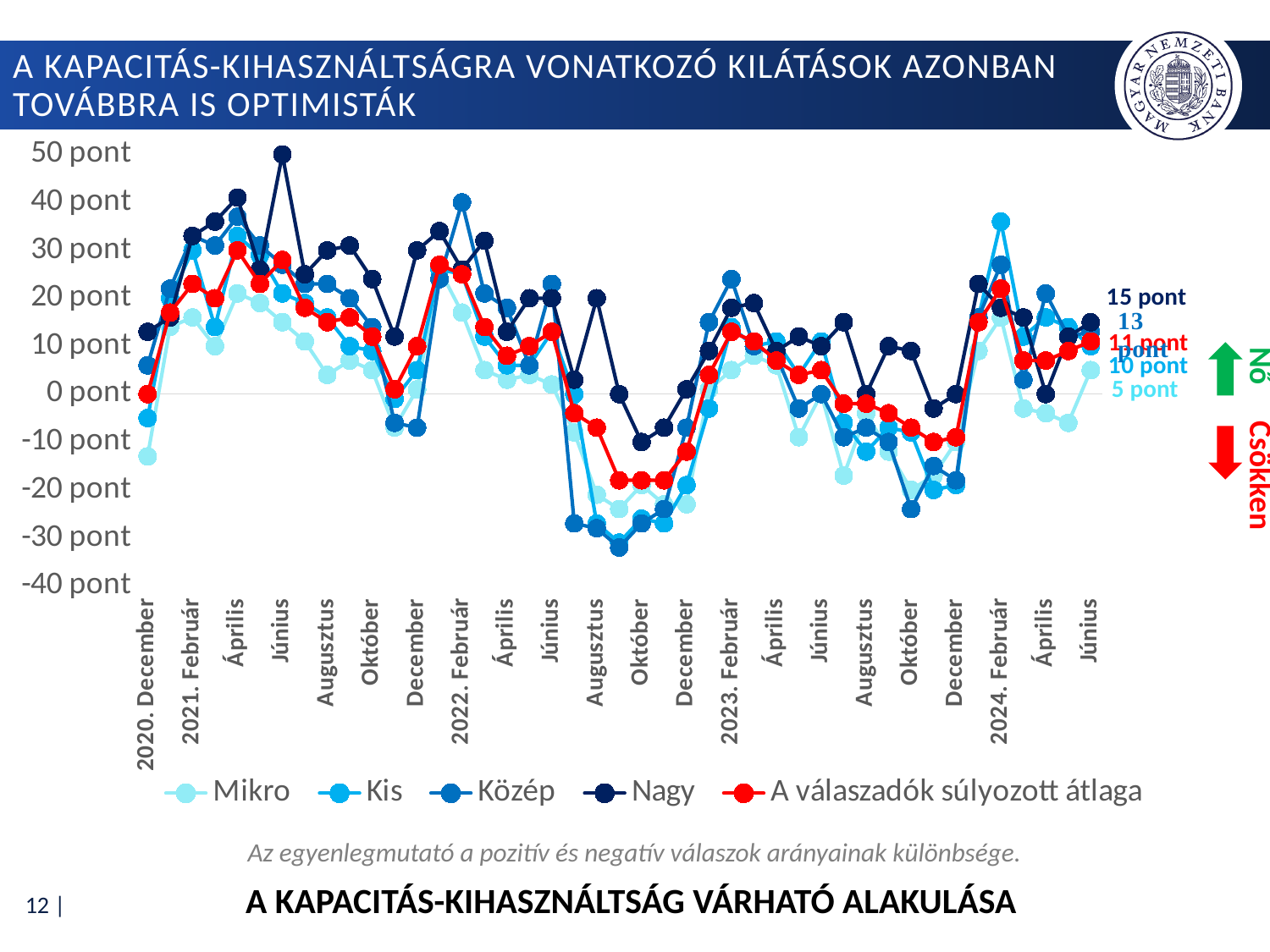
What is the title of the chart shown below the legend? A KAPACITÁS-KIHASZNÁLTSÁG VÁRHATÓ ALAKULÁSA What is the value labelled for 'A válaszadók súlyozott átlaga' at the end of the chart (2024 Június)? 11 pont What is the value labelled for the Nagy series at the end of the chart (2024 Június)? 15 pont What is the difference between the end-of-chart values of Nagy (15 pont) and Mikro (5 pont)? 10 pont Is the value for 'A válaszadók súlyozott átlaga' in 2022 Október greater or less than -10 pont? less Which series has the lowest value at the end of the chart (2024 Június)? Mikro Which series has the highest value at the end of the chart (2024 Június)? Nagy What is the value labelled for the Mikro series at the end of the chart (2024 Június)? 5 pont Is the value for the Nagy series in 2021 Június greater or less than 40 pont? greater What is the difference between the end-of-chart values of Nagy (15 pont) and 'A válaszadók súlyozott átlaga' (11 pont)? 4 pont What kind of chart is shown on the slide? line chart How many series does the legend list? 5